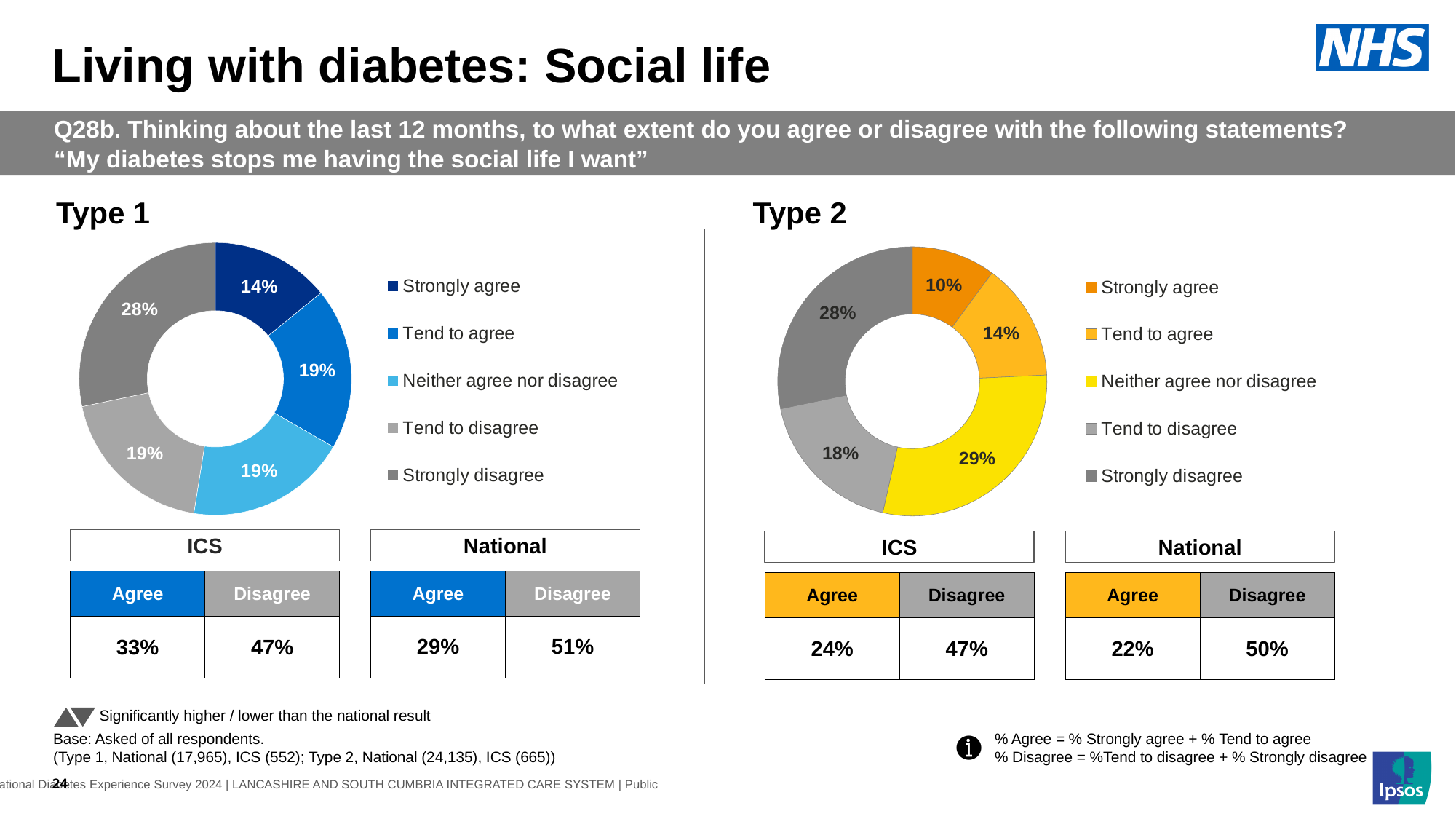
In the Type 1 chart, what percentage of respondents said 'Strongly agree'? 14% What kind of chart is used for the Type 2 data? Donut (pie) chart Comparing the two charts, which has the larger 'Strongly agree' share, Type 1 or Type 2? Type 1 How many response categories are shown in the Type 1 chart? 5 In the Type 2 chart, what percentage of respondents said 'Tend to disagree'? 18% In the Type 1 chart, which is larger: the 'Strongly disagree' share or the 'Strongly agree' share? Strongly disagree In the Type 2 chart, which response category has the smallest share? Strongly agree In the Type 2 chart, what colour represents 'Neither agree nor disagree'? Yellow In the Type 2 chart, what percentage of respondents said 'Neither agree nor disagree'? 29% In the Type 1 chart, which response category has the largest share? Strongly disagree In the Type 1 chart, what is the combined share of 'Strongly agree' and 'Tend to agree'? 33% In the Type 2 chart, what is the difference between the 'Neither agree nor disagree' share and the 'Strongly agree' share? 19 percentage points